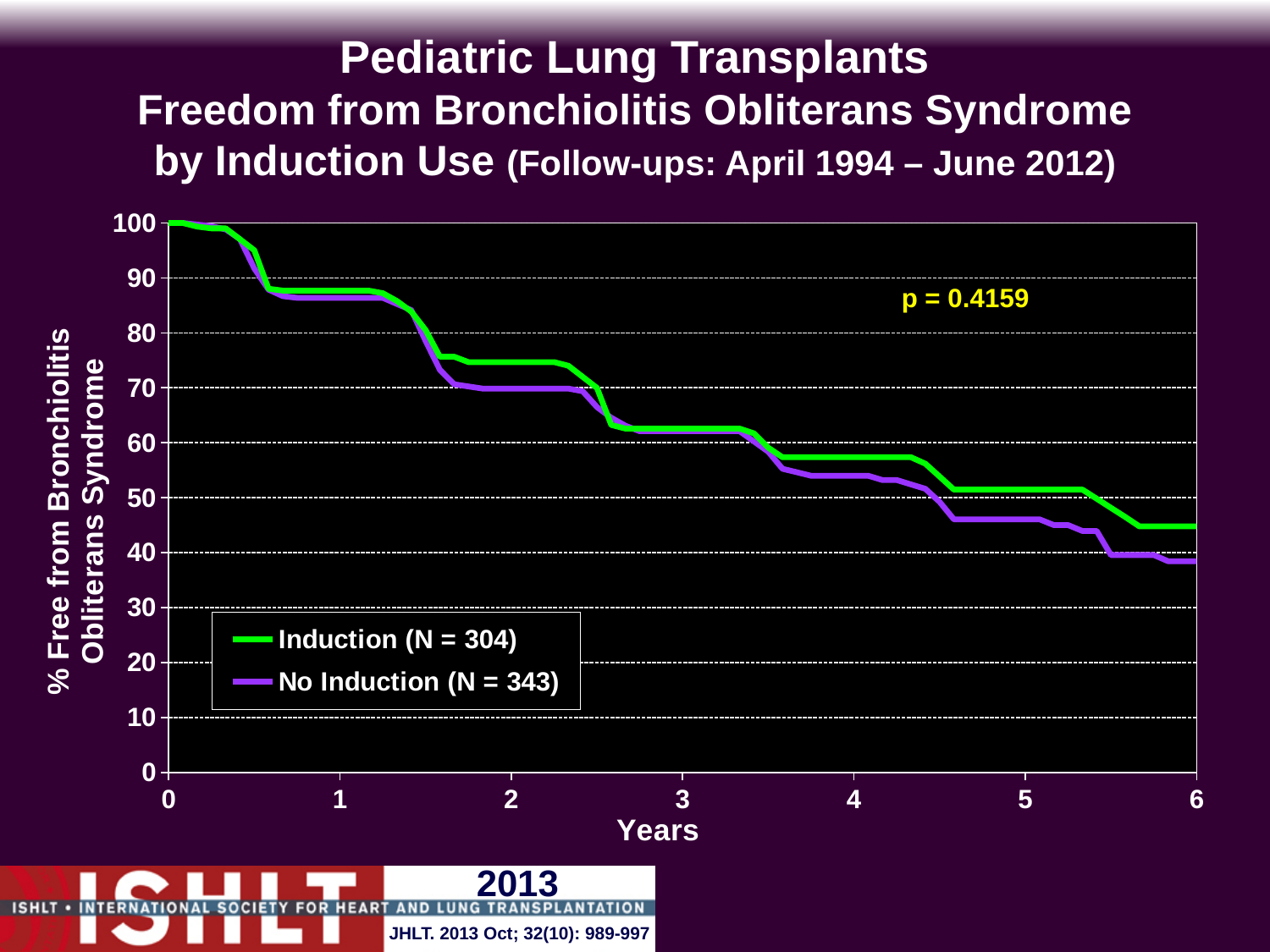
At 5 years, which series has the lower value, Induction or No Induction? No Induction What p-value is shown on the chart? p = 0.4159 Is the value for Induction at 4 years greater or less than 50? greater Is the value for No Induction at 2 years greater or less than 80? less Is the value for Induction at 6 years greater or less than 40? greater What kind of chart is shown on the slide? Line chart What is the N for the No Induction group shown in the legend? 343 Do the values for the Induction series rise or fall as the years increase? Fall How many series does the legend list? 2 At 6 years, which series has the higher value, Induction or No Induction? Induction